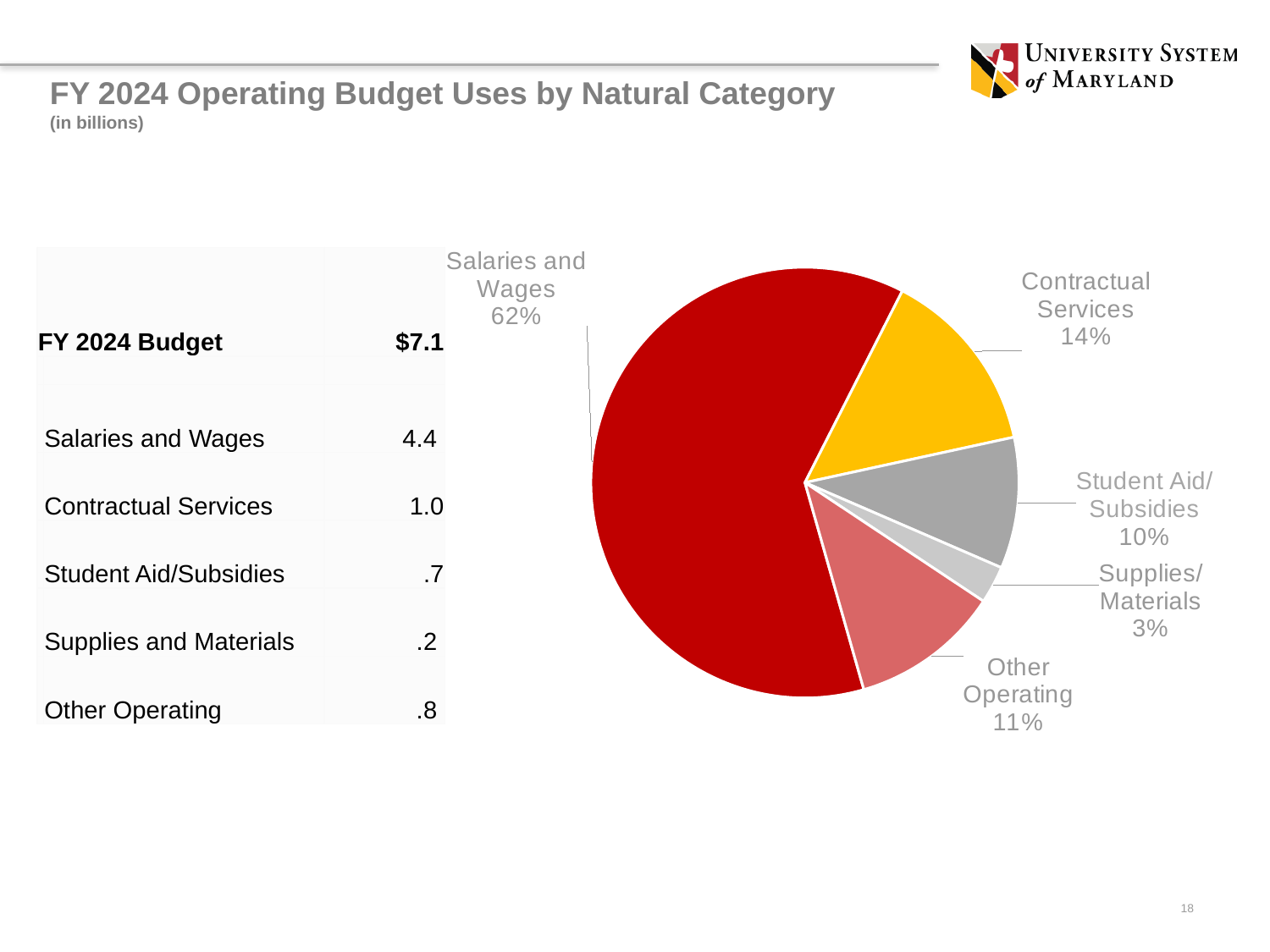
Which slice is larger, Contractual Services or Other Operating? Contractual Services What share of the pie does Contractual Services represent? 14% What colour is the Contractual Services slice? Yellow What share of the pie does Student Aid/Subsidies represent? 10% What kind of chart is shown on the slide? Pie chart Which category has the smallest slice of the pie? Supplies/Materials Which category has the largest slice of the pie? Salaries and Wages What share of the pie does Salaries and Wages represent? 62% How many slices does the pie chart have? 5 What is the difference in percentage points between the Salaries and Wages slice and the Contractual Services slice? 48